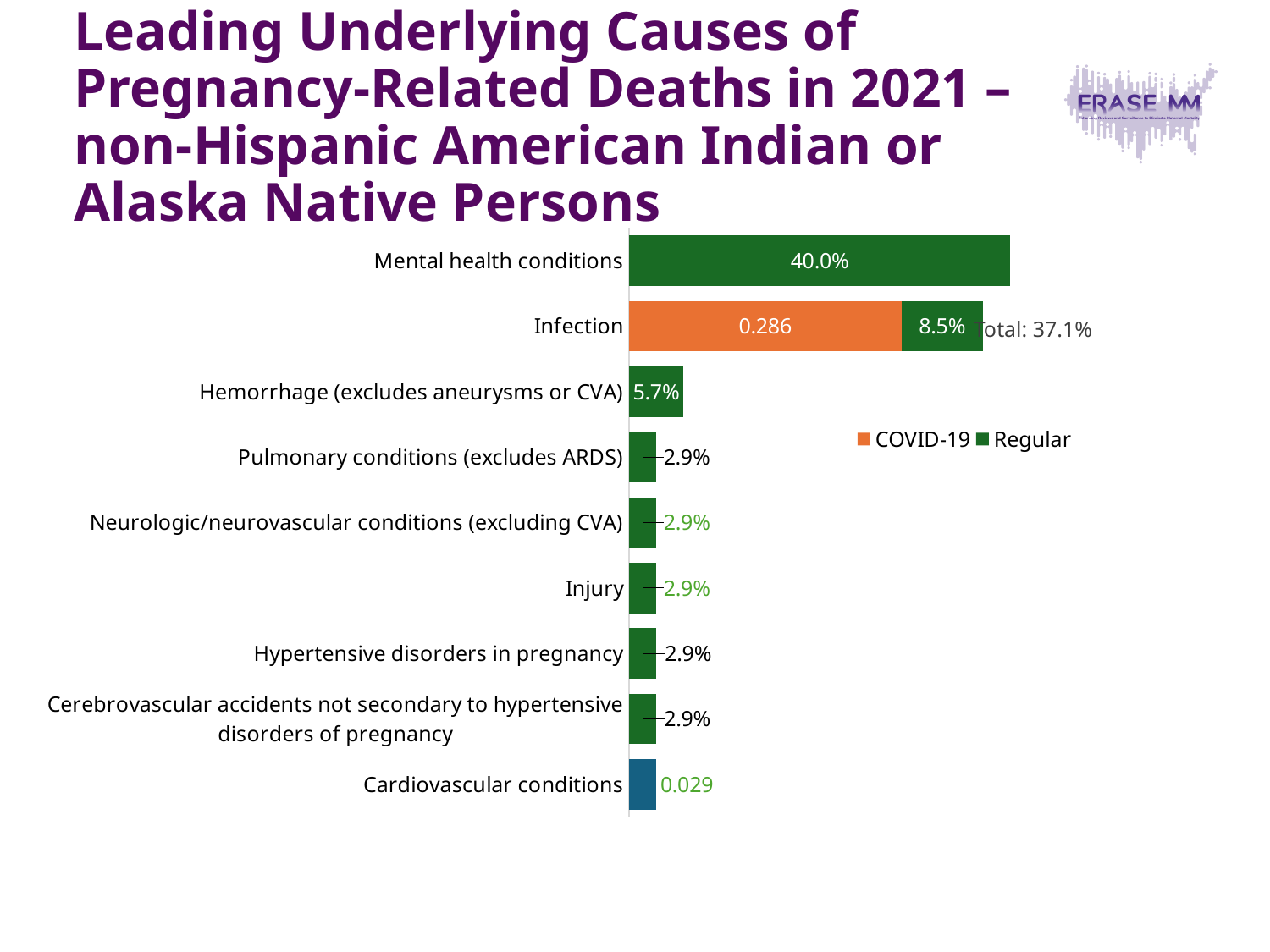
How many series does the legend list? 2 What is the value for Cardiovascular conditions? 0.029 What is the total shown for the Infection bar? 37.1% Which is larger, the value for Hemorrhage (excludes aneurysms or CVA) or the value for Injury? Hemorrhage (excludes aneurysms or CVA) What is the value for Mental health conditions? 40.0% Which category has the highest value? Mental health conditions What is the Regular value for Infection? 8.5% What is the COVID-19 value for Infection? 0.286 What kind of chart is shown on the slide? Bar chart What is the value for Hemorrhage (excludes aneurysms or CVA)? 5.7% What is the difference between the value for Mental health conditions and the value for Hemorrhage (excludes aneurysms or CVA)? 34.3% How many categories are shown on the chart? 9